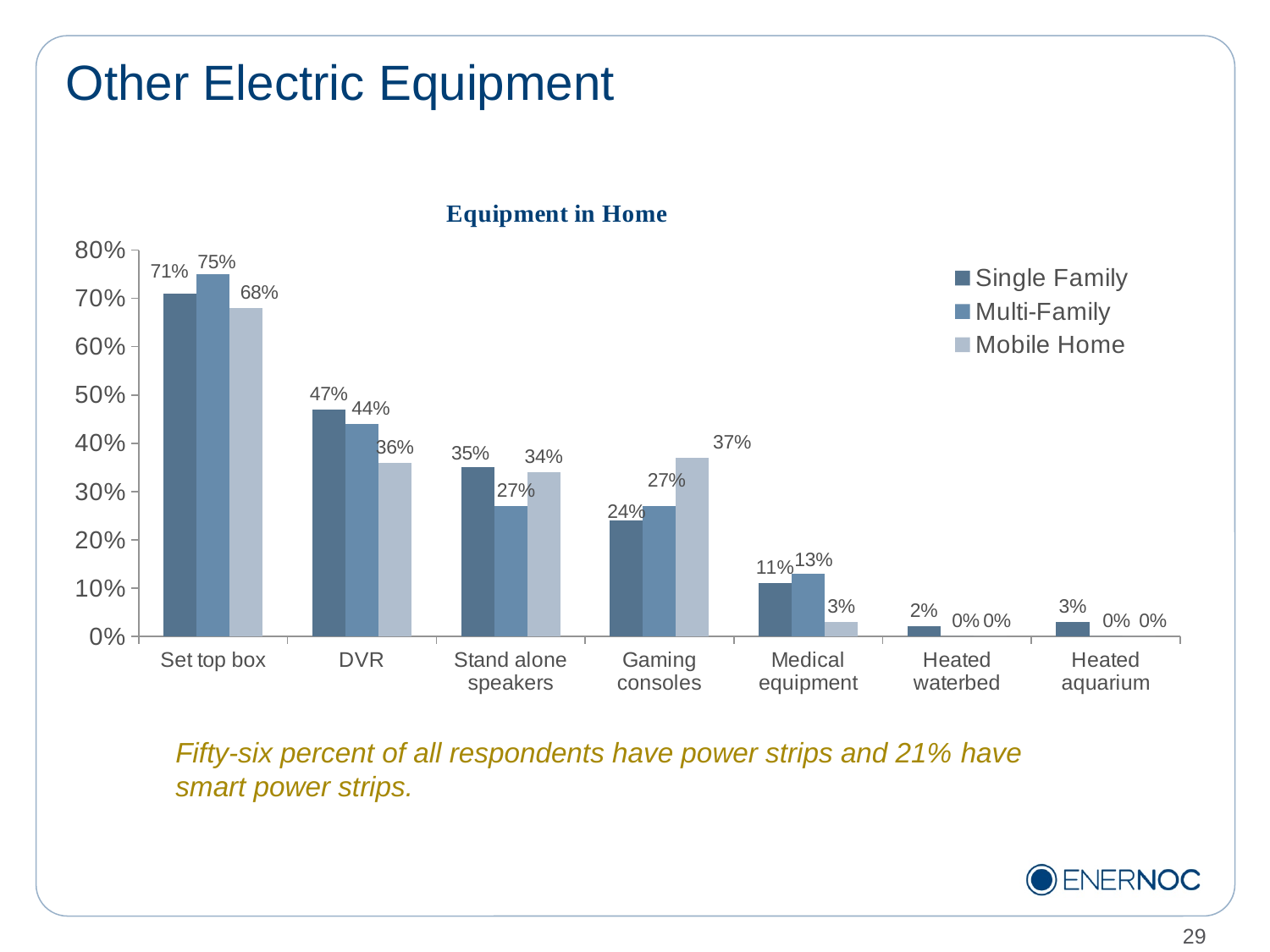
Which category has the lowest Single Family value? Heated waterbed How many categories are shown on the x axis? 7 What is the Multi-Family value for DVR? 44% Which is larger for Stand alone speakers: the Single Family value or the Multi-Family value? Single Family What is the difference between the Multi-Family and Mobile Home values for Set top box? 7% What kind of chart is shown? Bar chart Which category has the highest Multi-Family value? Set top box Is the Single Family value for DVR greater or less than 40%? greater What is the title of the chart? Equipment in Home What is the Single Family value for Set top box? 71% What is the Mobile Home value for Gaming consoles? 37% How many series does the legend list? 3